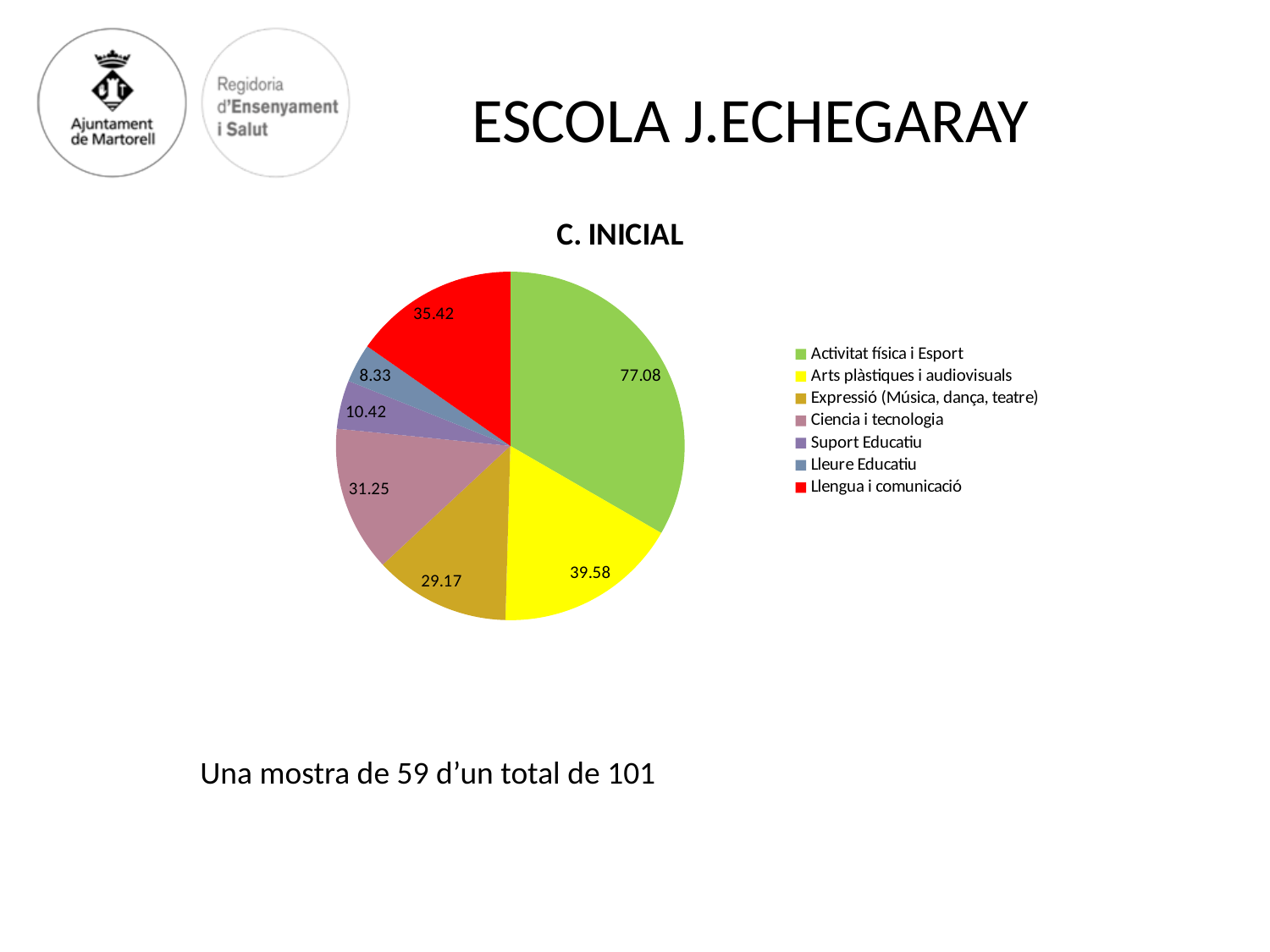
What type of chart is shown on the slide? Pie chart Which category has the largest slice in the C. INICIAL pie chart? Activitat física i Esport What is the value for Llengua i comunicació in the pie chart? 35.42 What value is shown for Suport Educatiu? 10.42 How many categories does the C. INICIAL pie chart contain? 7 What is the difference between the values for Ciencia i tecnologia and Expressió (Música, dança, teatre)? 2.08 Which has a larger value, Llengua i comunicació or Ciencia i tecnologia? Llengua i comunicació What is the difference between the values for Activitat física i Esport and Arts plàstiques i audiovisuals? 37.50 What is the value shown for Activitat física i Esport in the C. INICIAL pie chart? 77.08 Which category has the smallest slice in the pie chart? Lleure Educatiu What is the title of the chart on the slide? C. INICIAL What value is labelled on the Arts plàstiques i audiovisuals slice? 39.58